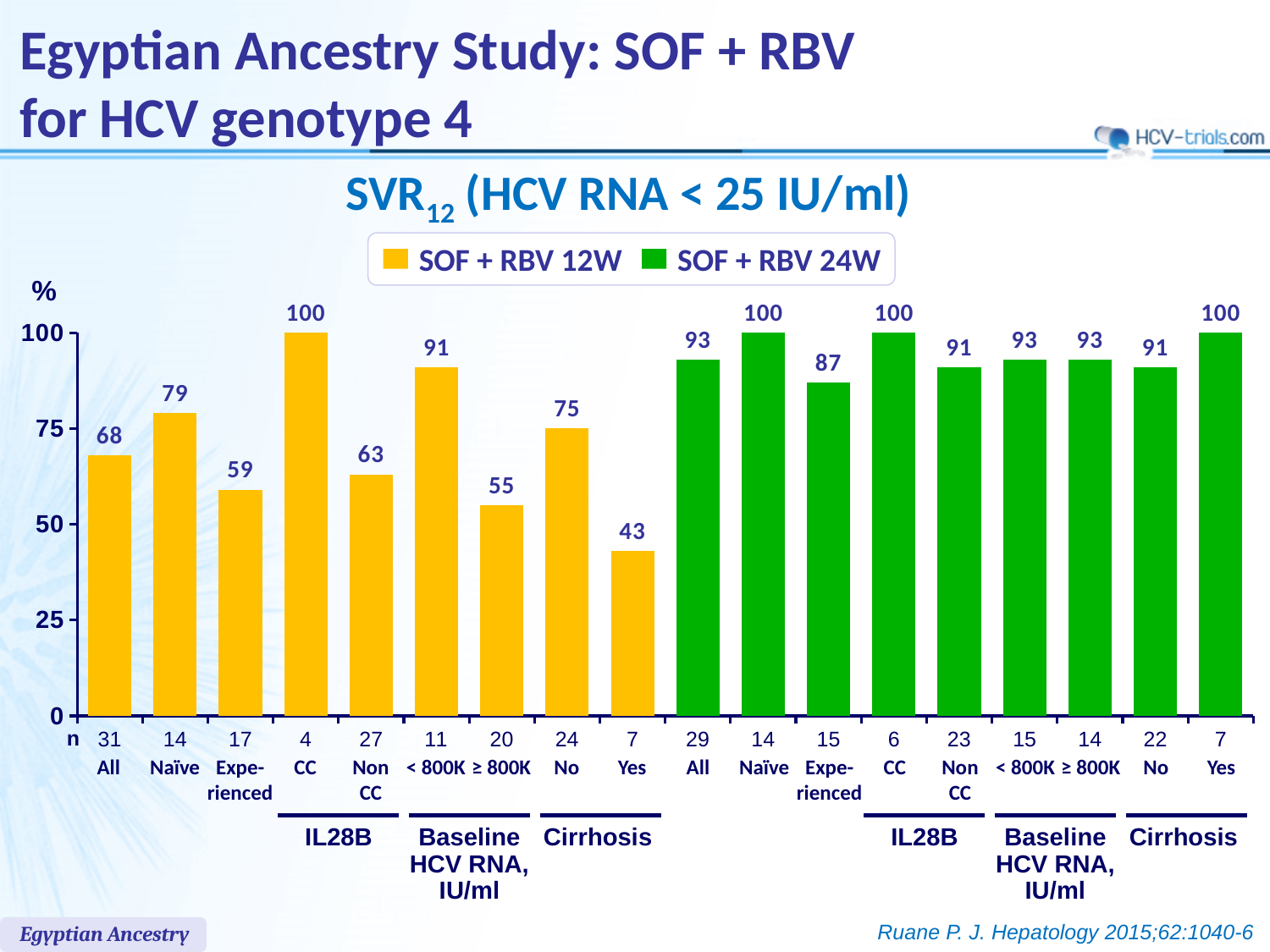
What kind of chart is shown on the slide? bar chart What is the SVR12 rate for the All group with SOF + RBV 12W? 68 What is the SVR12 rate for treatment-experienced patients in the SOF + RBV 12W arm? 59 What is the difference in SVR12 rate between the All groups of the SOF + RBV 24W and SOF + RBV 12W arms? 25 Which subgroup has the lowest SVR12 rate in the SOF + RBV 24W arm? Experienced What is the difference in SVR12 rate between the IL28B CC and Non CC groups in the SOF + RBV 12W arm? 37 What colour represents the SOF + RBV 24W series? green Which has a higher SVR12 rate in the SOF + RBV 12W arm: baseline HCV RNA < 800K or ≥ 800K? < 800K Which subgroup has the lowest SVR12 rate in the SOF + RBV 12W arm? Cirrhosis Yes What is the SVR12 rate for patients with cirrhosis (Yes) in the SOF + RBV 24W arm? 100 Is the SVR12 rate for cirrhosis Yes in the SOF + RBV 12W arm greater or less than 50? less How many series does the legend list? 2